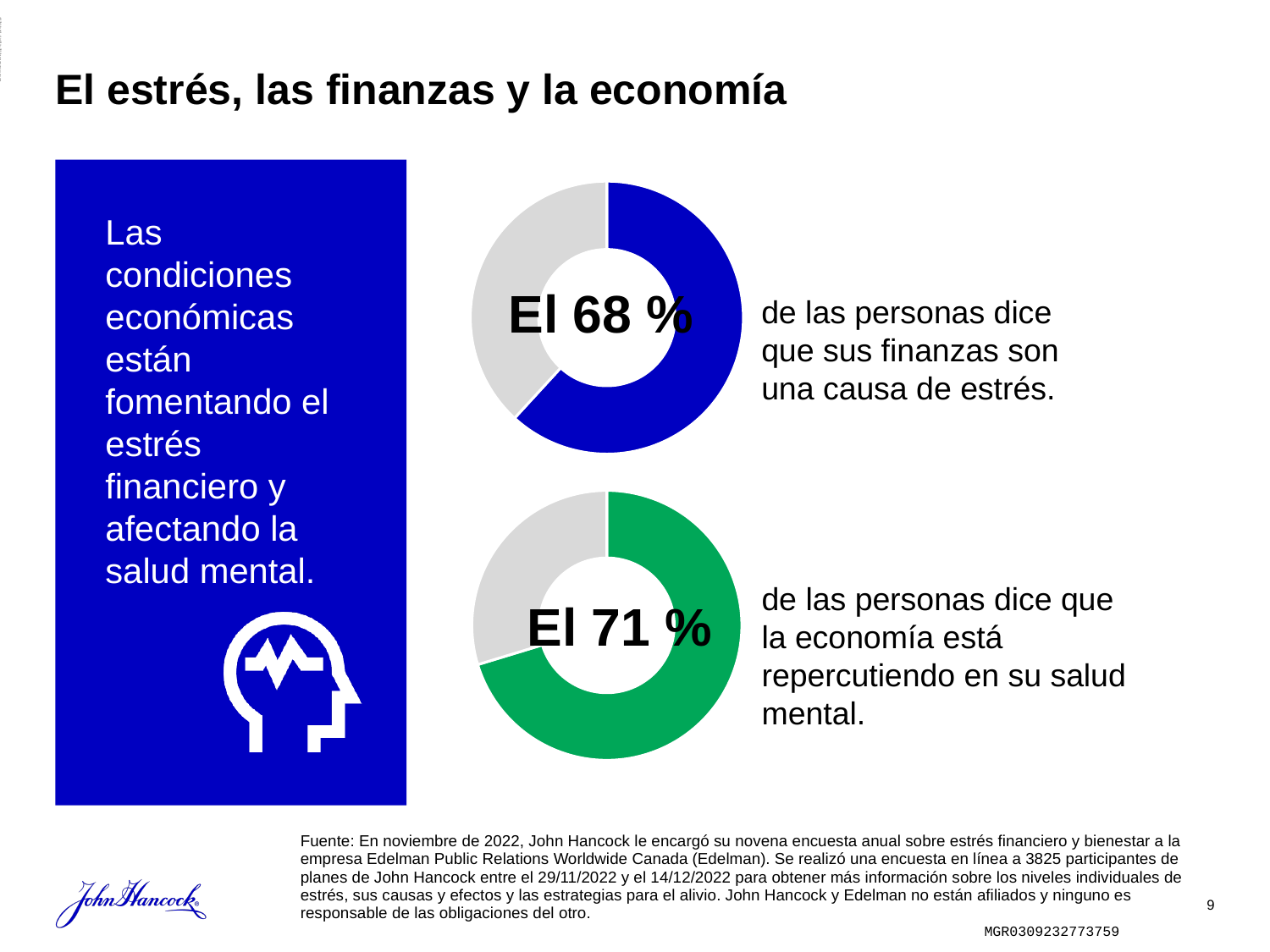
Is the highlighted value in the top donut chart greater or less than 50 %? greater In the bottom donut chart, what percentage of people say the economy is affecting their mental health? 71 % What colour is the highlighted segment in the top donut chart? Blue What kind of chart is used to show the 68 % figure at the top of the slide? Donut chart How many donut charts are shown on the slide? 2 What is the difference in percentage points between the bottom chart's value (71 %) and the top chart's value (68 %)? 3 percentage points Is the highlighted value in the bottom donut chart greater or less than 75 %? less In the top donut chart, what percentage of people say their finances are a cause of stress? 68 % Which is larger: the percentage in the top chart (finances as a cause of stress) or the percentage in the bottom chart (economy affecting mental health)? The bottom chart (71 %) What colour is the highlighted segment in the bottom donut chart? Green